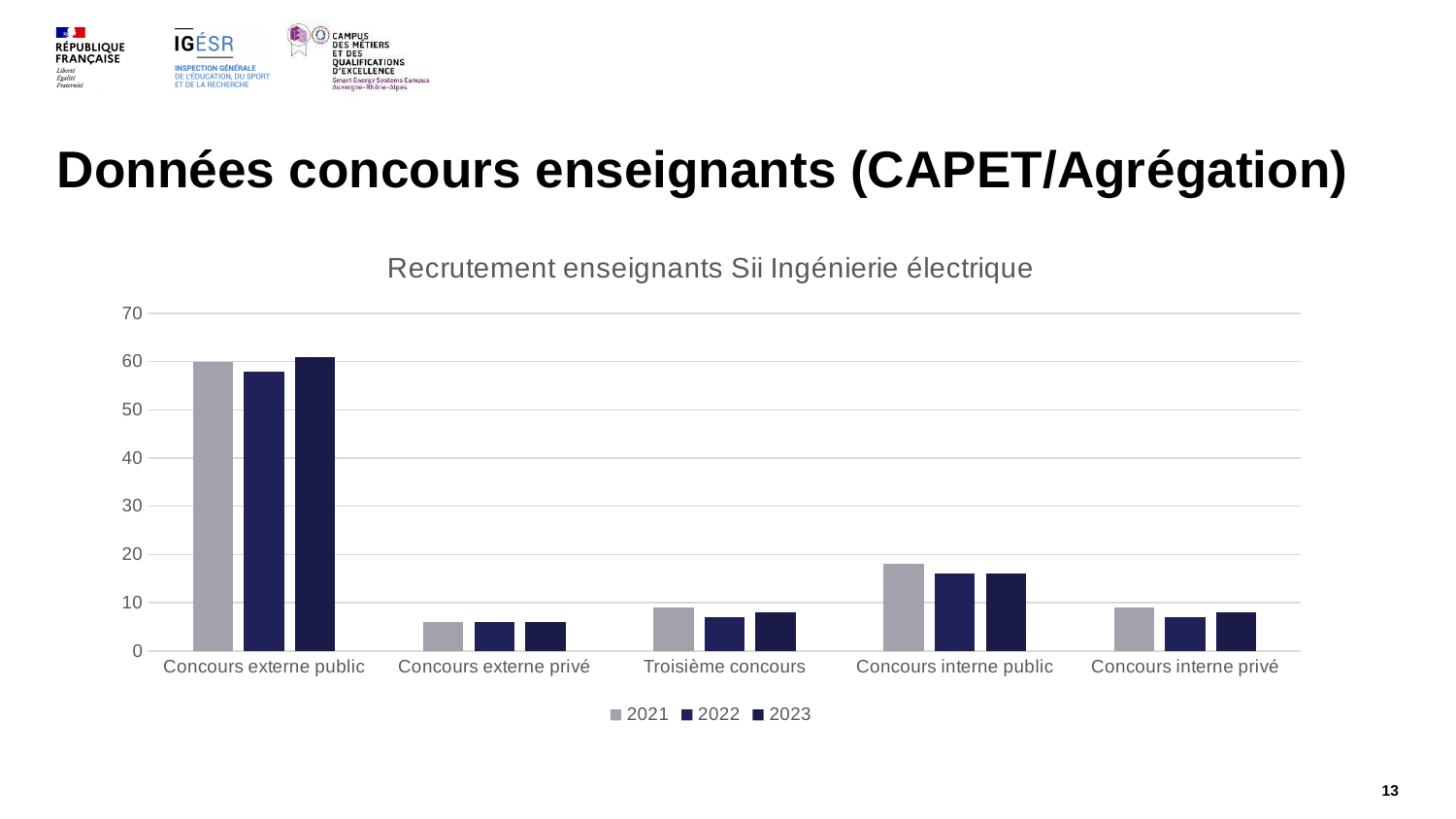
Is the 2021 value for Concours externe privé greater or less than 10? less Is the 2021 value for Concours interne public greater or less than 20? less What is the 2021 value for Concours externe public? 60 Which category has the highest values across all three years? Concours externe public Is the 2022 value for Concours externe public greater or less than 50? greater How many series does the legend list? 3 Which category has the lowest values across all three years? Concours externe privé Which years are listed in the legend? 2021, 2022, 2023 For 2021, which is larger: Concours interne public or Troisième concours? Concours interne public How many categories are shown on the x axis? 5 What type of chart is shown on the slide? Bar chart What is the title of the chart? Recrutement enseignants Sii Ingénierie électrique